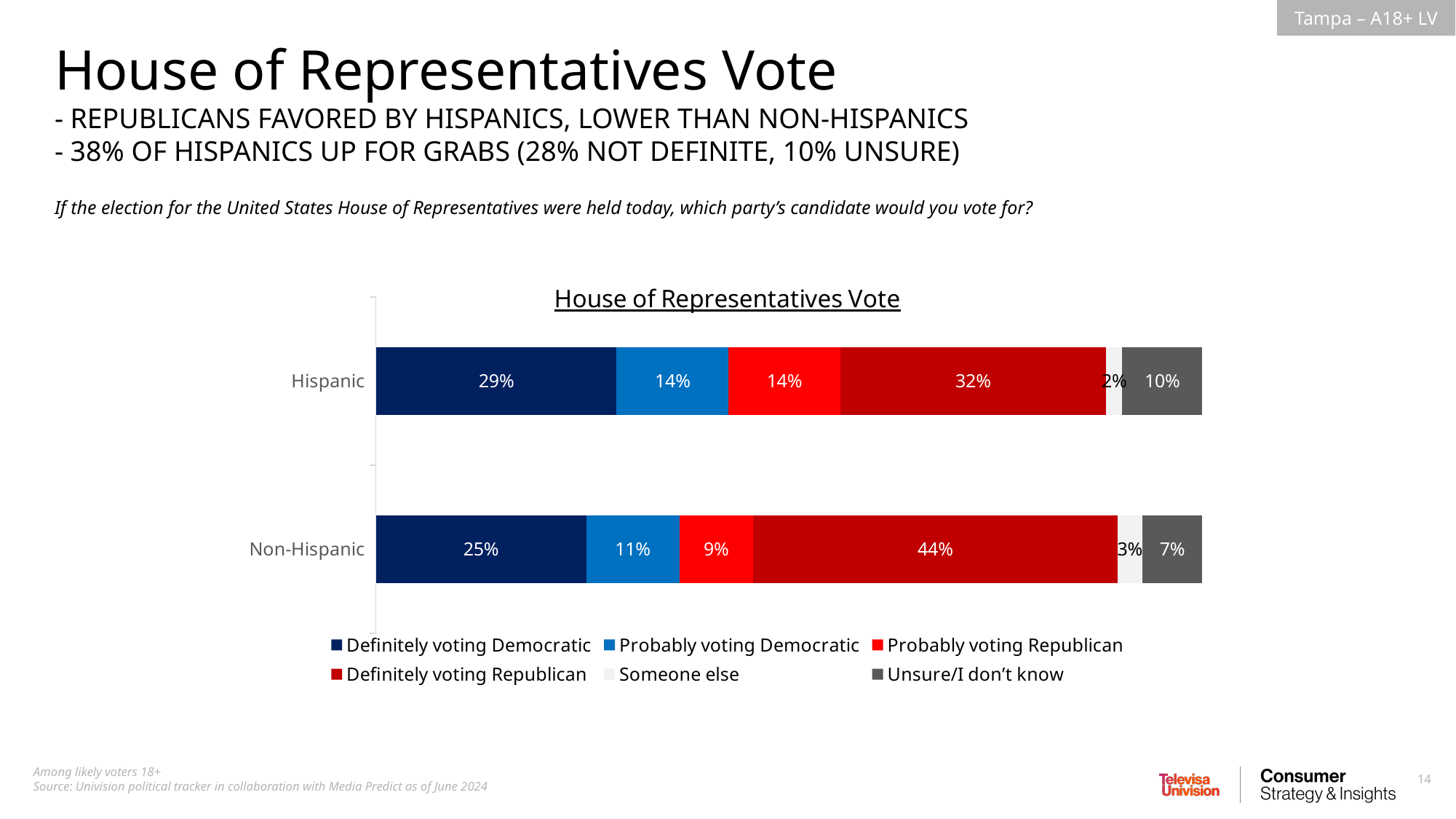
What is the value for Unsure/I don't know among Hispanic voters? 10% How many categories (groups) are shown on the chart? 2 How many series does the legend list? 6 Which response has the smallest share among Hispanic voters? Someone else Which group has a higher share of Probably voting Democratic, Hispanic or Non-Hispanic? Hispanic What is the title of the chart? House of Representatives Vote Which response has the largest share among Non-Hispanic voters? Definitely voting Republican What kind of chart is shown on the slide? Stacked bar chart What is the value for Probably voting Republican among Non-Hispanic voters? 9% What percentage of Hispanic likely voters are definitely voting Democratic? 29% What percentage of Non-Hispanic likely voters are definitely voting Republican? 44% What is the difference between the Definitely voting Republican share for Non-Hispanic voters and for Hispanic voters? 12 percentage points